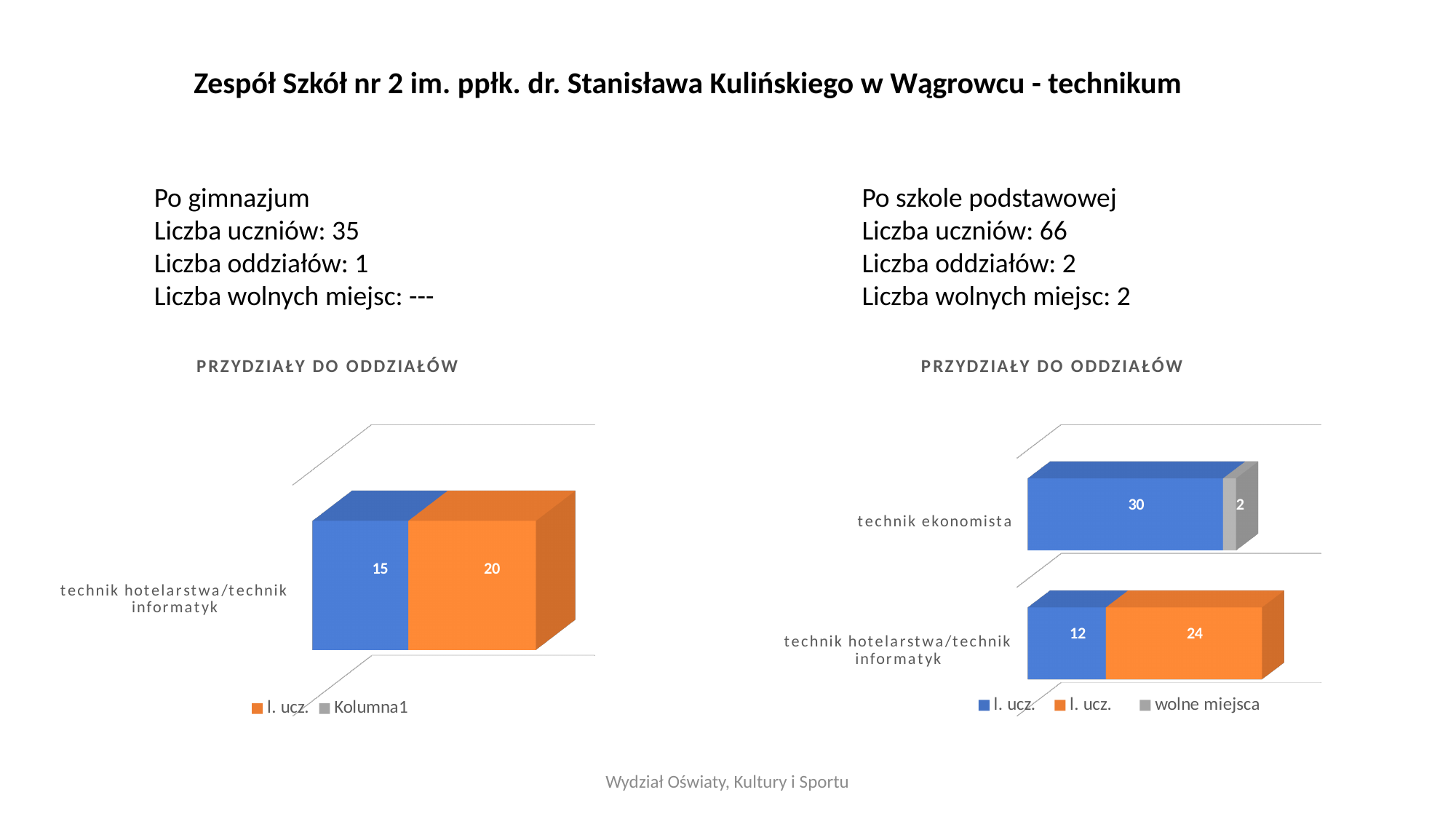
In the left chart, what is the total of the stacked bar for technik hotelarstwa/technik informatyk? 35 How many entries does the legend of the right chart list? 3 In the right chart, what is the total of the stacked bar for technik hotelarstwa/technik informatyk? 36 In the right chart, what is the value of the orange segment for technik hotelarstwa/technik informatyk? 24 How many entries does the legend of the left chart list? 2 In the left chart, what is the value of the blue segment for technik hotelarstwa/technik informatyk? 15 How many categories does the left chart show? 1 In the right chart, what is the value of the blue segment for technik ekonomista? 30 In the left chart, what is the value of the orange segment for technik hotelarstwa/technik informatyk? 20 What kind of chart is the right chart? bar chart In the right chart, what is the difference between the blue segment for technik ekonomista and the blue segment for technik hotelarstwa/technik informatyk? 18 In the right chart, what is the value of the grey segment (wolne miejsca) for technik ekonomista? 2